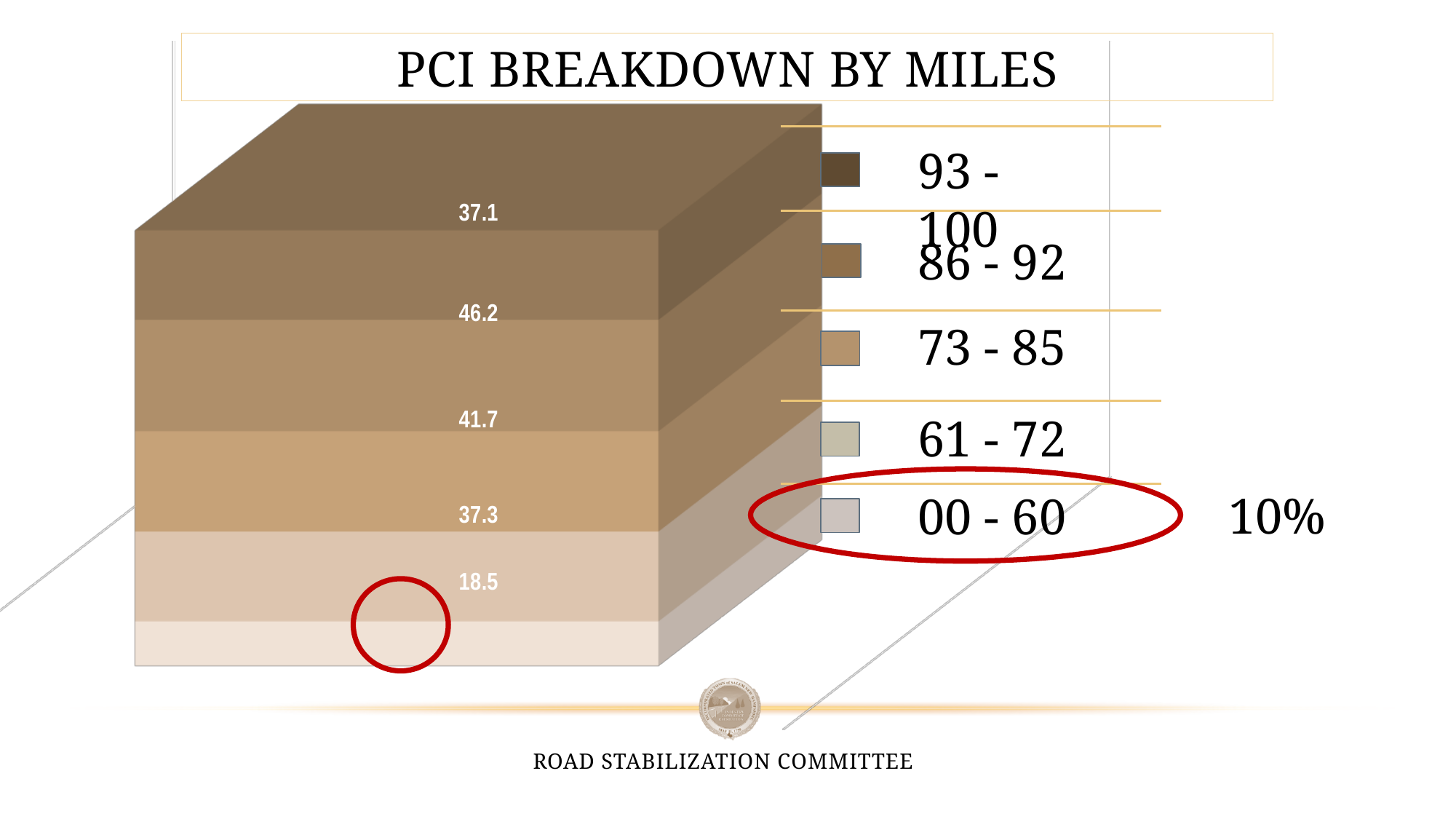
What is the total of all segments in the stacked bar? 180.8 Which PCI range has the largest value? 86 - 92 How many series does the legend list? 5 What is the value for the 86 - 92 segment? 46.2 What is the value for the 61 - 72 segment? 37.3 Which is larger, the value for 73 - 85 or the value for 61 - 72? 73 - 85 What is the value for the 93 - 100 segment in the PCI Breakdown by Miles chart? 37.1 What is the value for the 73 - 85 segment? 41.7 Which PCI range has the smallest value? 00 - 60 What is the difference between the 86 - 92 value and the 00 - 60 value? 27.7 What is the value for the 00 - 60 segment? 18.5 What kind of chart is shown on the slide? Stacked bar chart